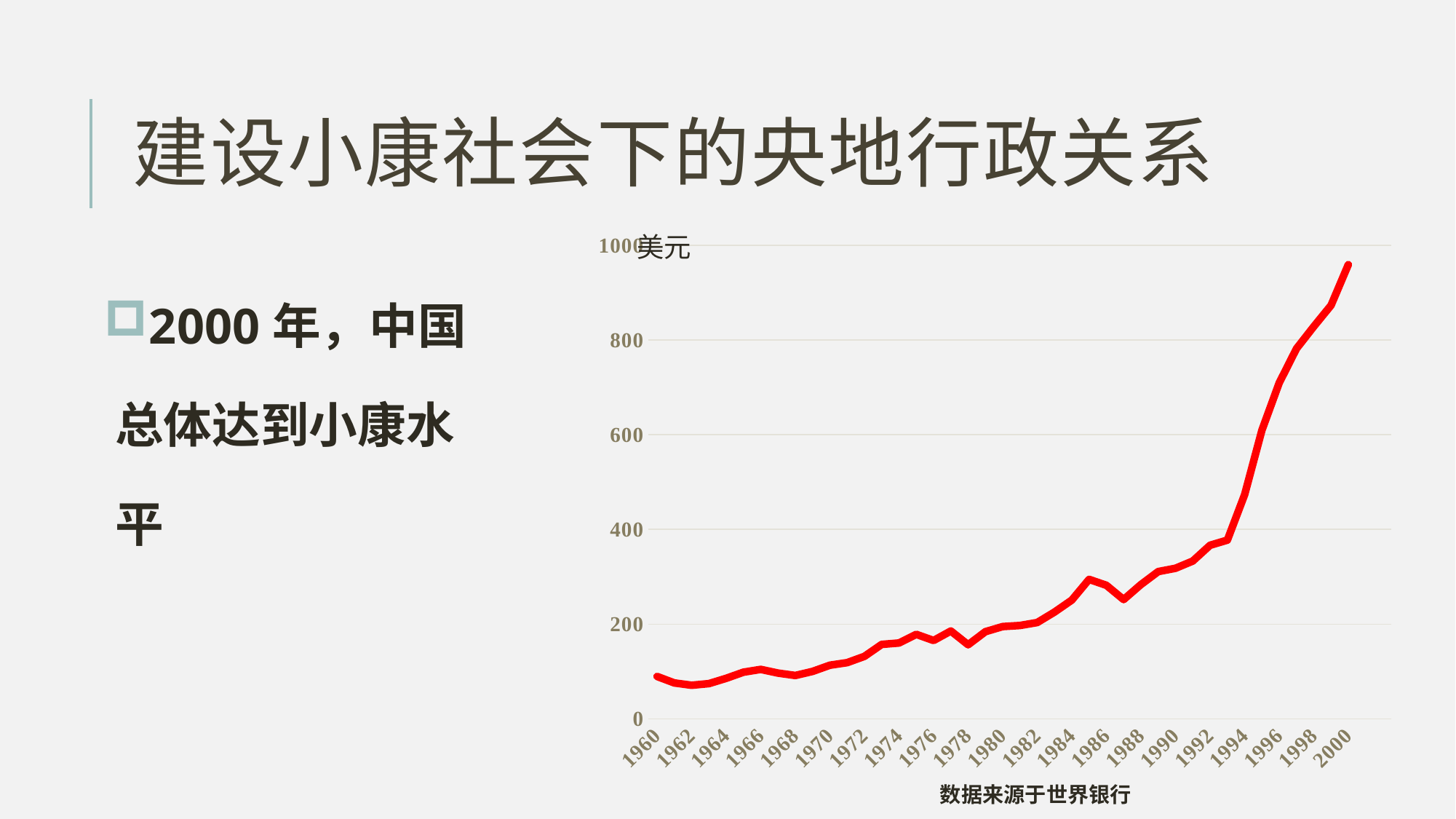
Is the value for 1970 greater or less than 200? less Is the value for 2000 greater or less than 800? greater Is the value for 1986 greater or less than 200? greater Do the values generally rise or fall from 1960 to 2000? rise Which is larger, the value for 2000 or the value for 1960? 2000 Which year has the highest value on the chart? 2000 What unit is shown at the top of the y axis? 美元 How many year labels are shown on the x axis? 21 What kind of chart is shown on the slide? line chart Which year has the lowest value on the chart? 1962